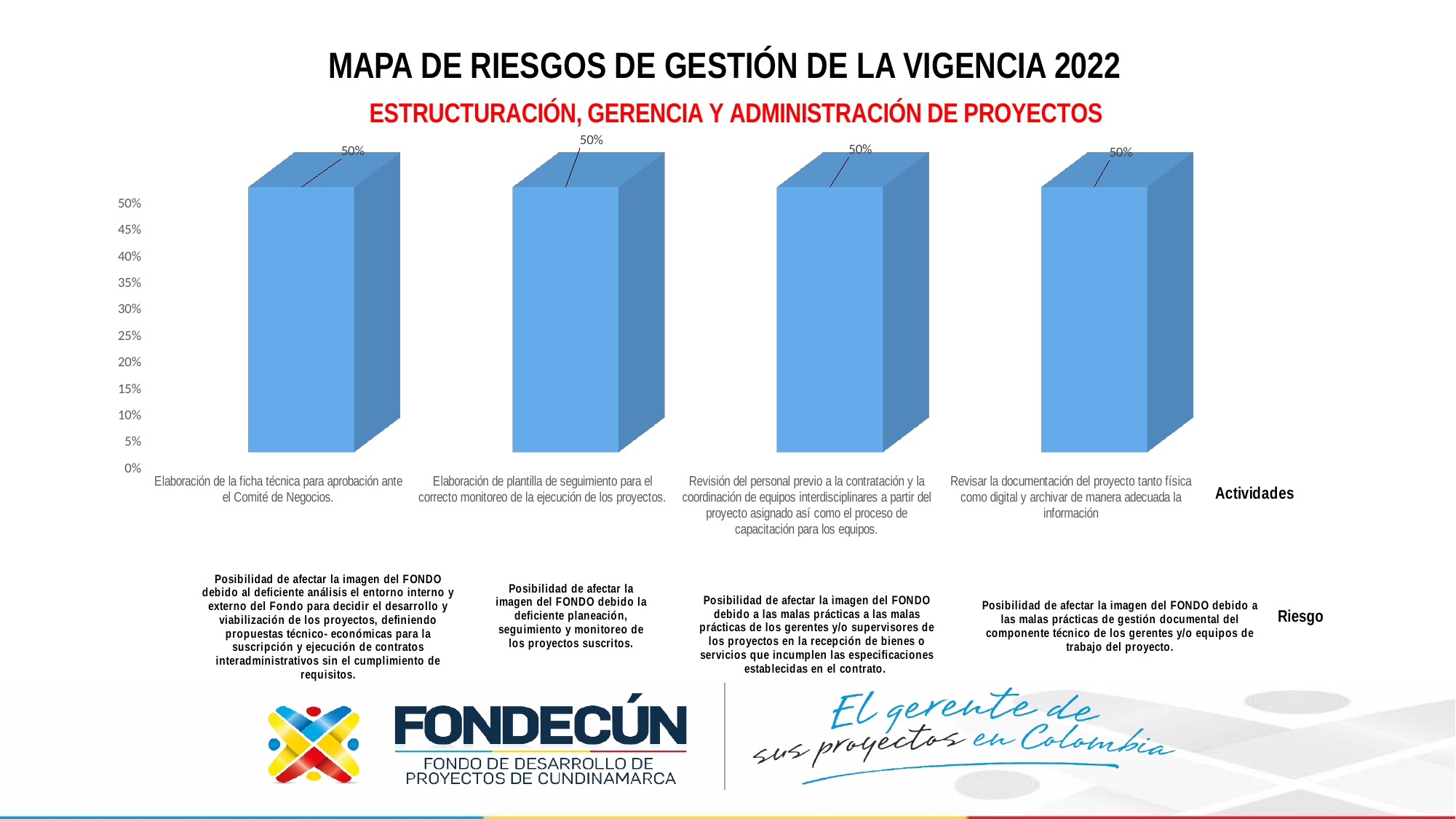
What kind of chart is shown on the slide? Bar chart What is the value for the activity "Revisión del personal previo a la contratación y la coordinación de equipos interdisciplinares..."? 50% What is the value for the activity "Revisar la documentación del proyecto tanto física como digital y archivar de manera adecuada la información"? 50% Is the value for "Elaboración de plantilla de seguimiento..." greater or less than 25%? greater What is the value for the activity "Elaboración de plantilla de seguimiento para el correcto monitoreo de la ejecución de los proyectos"? 50% What is the main title of the slide above the chart? MAPA DE RIESGOS DE GESTIÓN DE LA VIGENCIA 2022 What is the value for the activity "Elaboración de la ficha técnica para aprobación ante el Comité de Negocios"? 50% How many activities (bars) are plotted in the chart? 4 What is the highest value shown on the vertical axis? 50% What is the difference between the value for "Elaboración de la ficha técnica..." and the value for "Revisar la documentación del proyecto..."? 0% Do the values rise, fall, or stay the same across the activities along the x axis? Stay the same